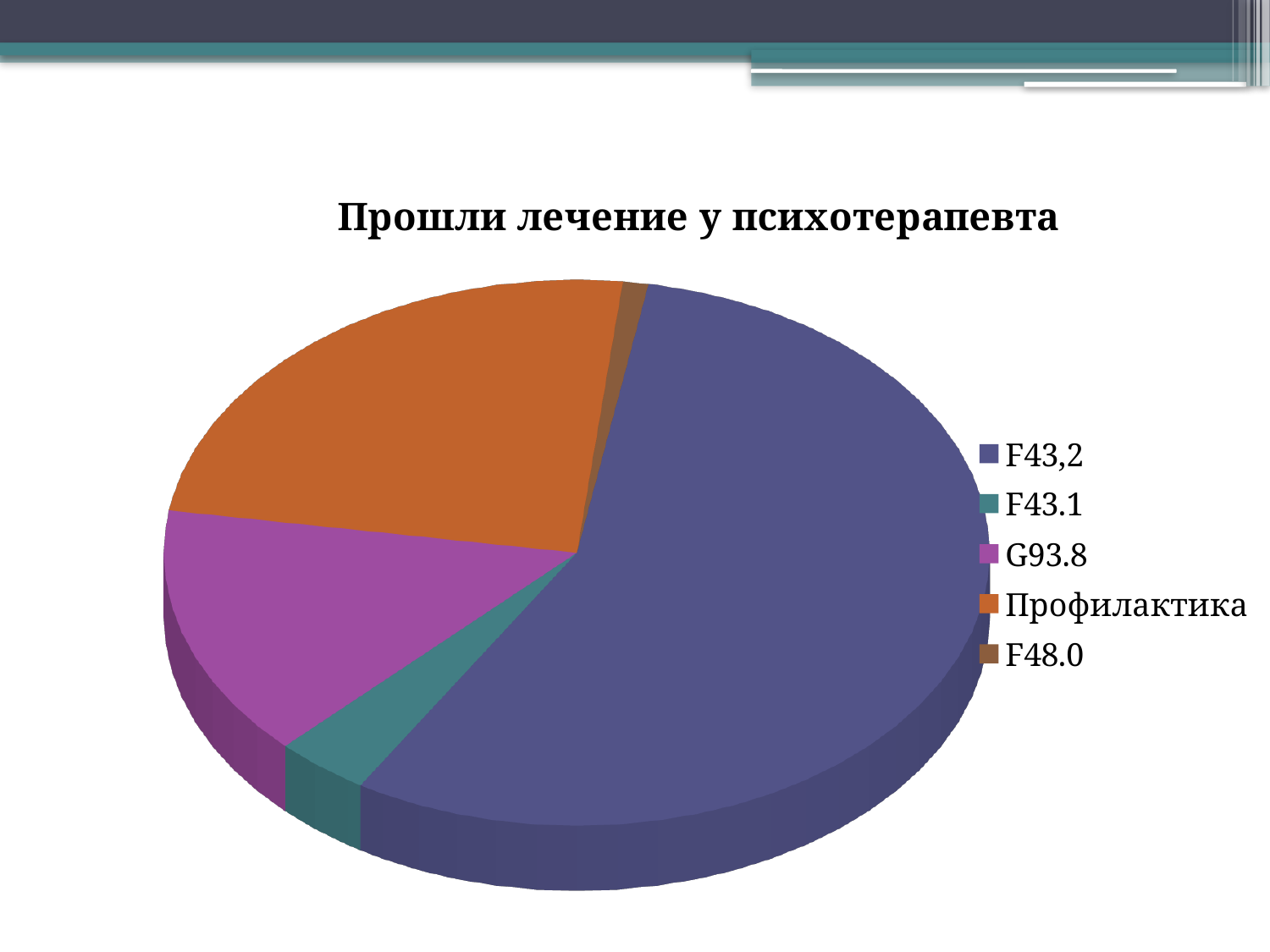
Which slice is larger, Профилактика or G93.8? Профилактика Which category has the smallest slice of the pie? F48.0 What colour is the slice for Профилактика? Orange How many entries does the legend list? 5 Which slice is larger, F43.1 or F48.0? F43.1 Which category has the largest slice of the pie? F43,2 How many categories (slices) does the pie chart have? 5 Which slice is larger, F43,2 or Профилактика? F43,2 What is the title of the chart? Прошли лечение у психотерапевта What kind of chart is shown on the slide? Pie chart